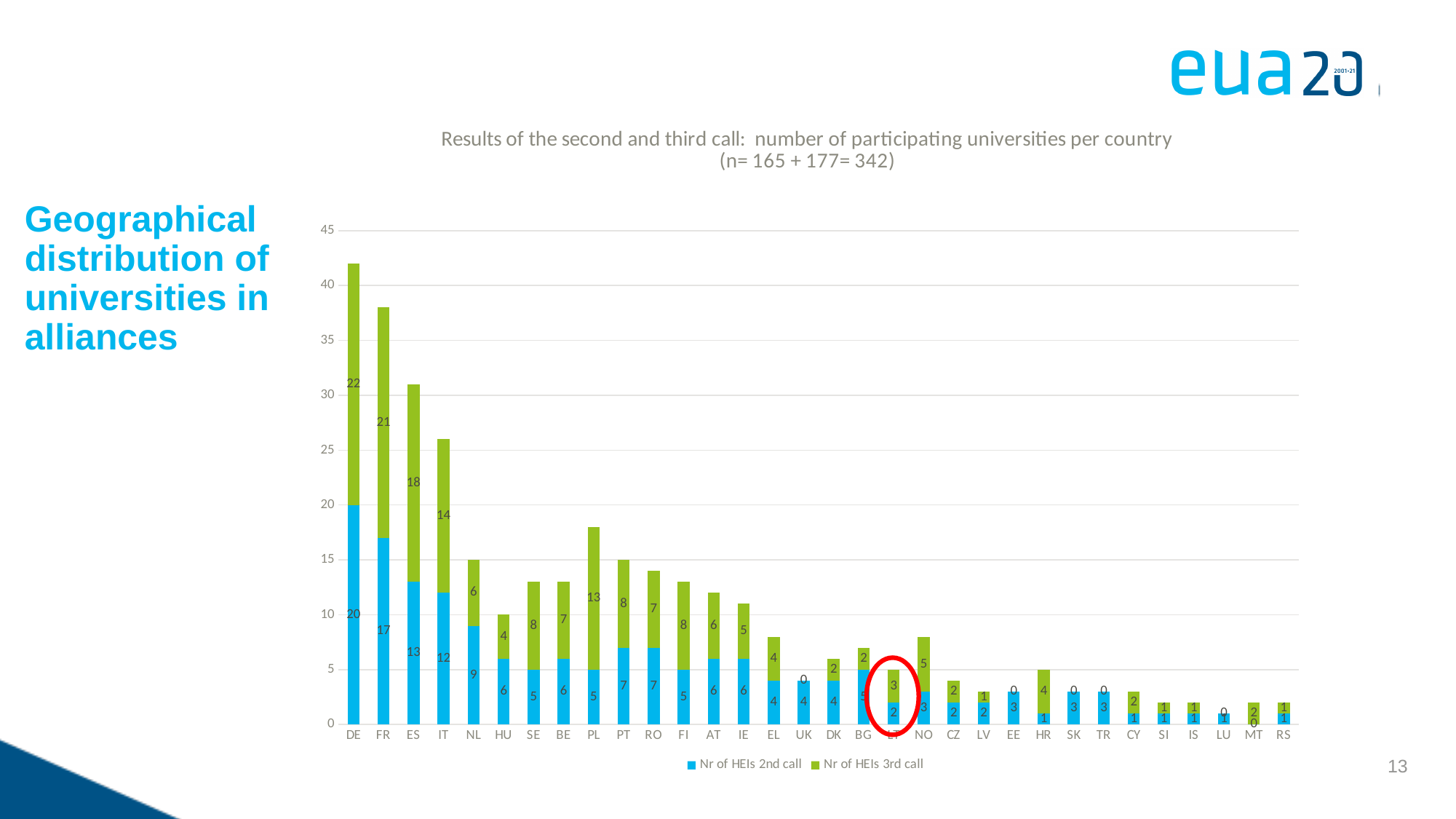
How many series does the legend list? 2 Which country has the highest total number of participating universities? DE What is the total of the stacked bar for ES? 31 What type of chart is shown on the slide? Stacked bar chart What is the value of Nr of HEIs 3rd call for FR? 21 What is the difference between Nr of HEIs 3rd call and Nr of HEIs 2nd call for PL? 8 What is the value of Nr of HEIs 3rd call for PL? 13 Which is larger for NL: Nr of HEIs 2nd call or Nr of HEIs 3rd call? Nr of HEIs 2nd call Is the total value for FR greater or less than 35? greater What is the total of the stacked bar for IT? 26 What is the value of Nr of HEIs 2nd call for DE? 20 Which country is circled in red on the chart? LT